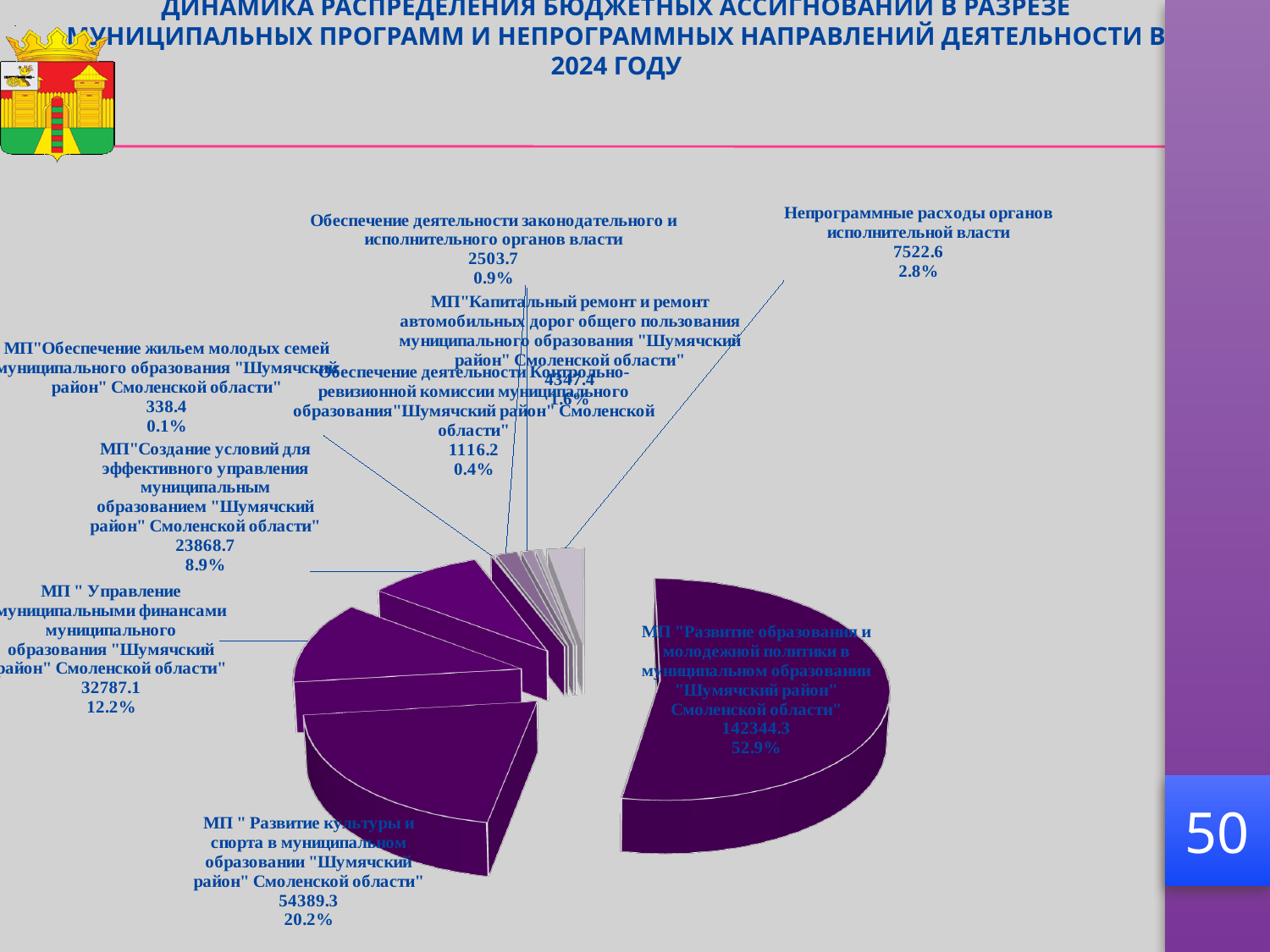
What share of the pie does МП "Развитие образования и молодежной политики" account for? 52.9% Which category has the largest slice of the pie chart? МП "Развитие образования и молодежной политики в муниципальном образовании "Шумячский район" Смоленской области" How many slices does the pie chart have? 9 What kind of chart is shown on the slide? Pie chart What value is shown for Непрограммные расходы органов исполнительной власти? 7522.6 What value is shown for МП"Создание условий для эффективного управления муниципальным образованием"? 23868.7 What share of the pie does МП "Управление муниципальными финансами" account for? 12.2% Which category has the smallest slice of the pie chart? МП"Обеспечение жильем молодых семей муниципального образования "Шумячский район" Смоленской области" What is the difference between the value for МП "Развитие культуры и спорта" (54389.3) and МП "Управление муниципальными финансами" (32787.1)? 21602.2 Which is larger: the value for МП "Развитие культуры и спорта" or the value for МП "Управление муниципальными финансами"? МП "Развитие культуры и спорта" What percentage is shown for Обеспечение деятельности Контрольно-ревизионной комиссии? 0.4% What value is shown for МП "Развитие культуры и спорта в муниципальном образовании "Шумячский район" Смоленской области"? 54389.3